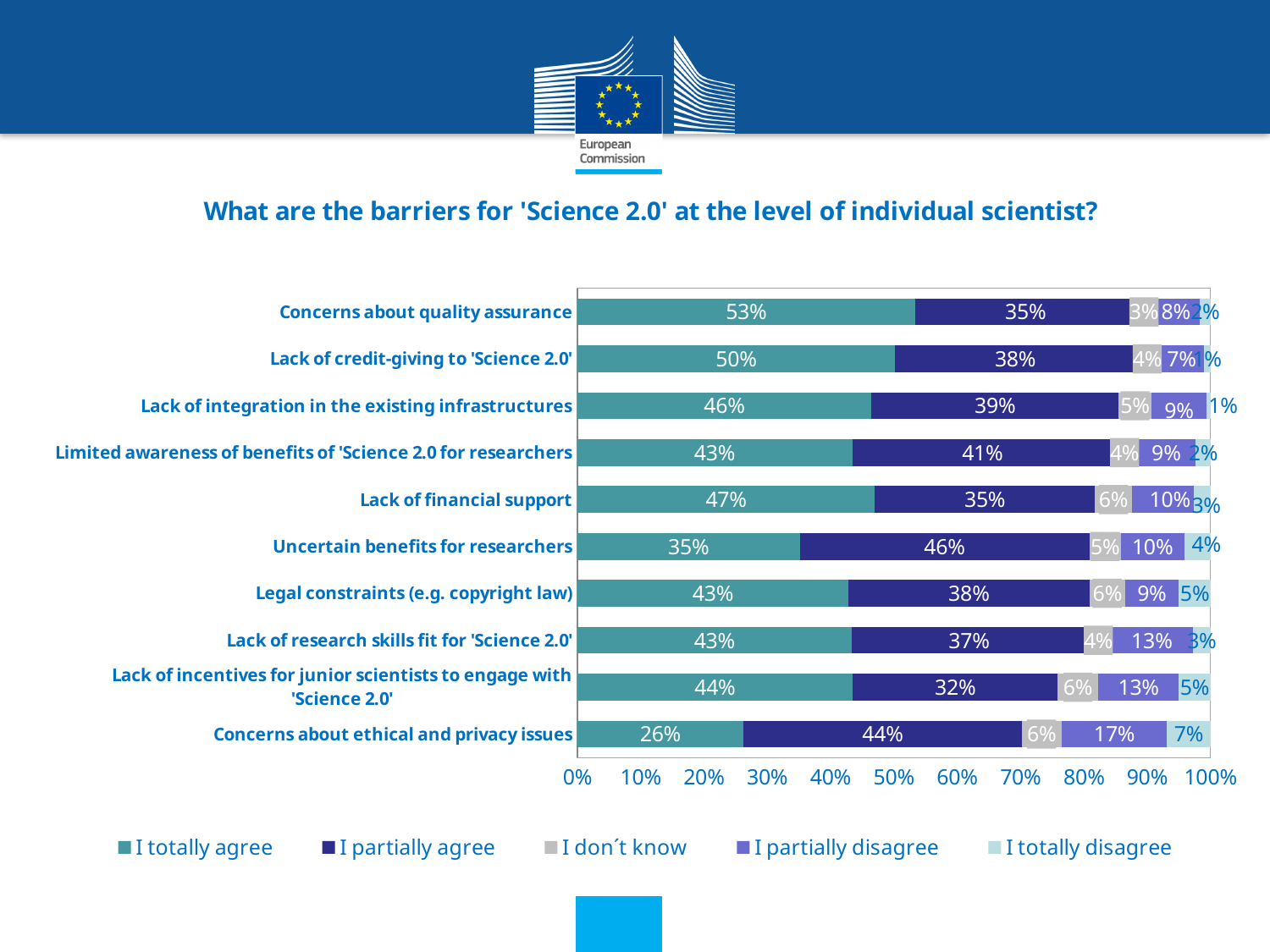
How many barriers (categories) are shown in the chart? 10 Which barrier has the highest 'I totally agree' share? Concerns about quality assurance What is the 'I partially disagree' value for 'Concerns about ethical and privacy issues'? 17% What is the 'I totally agree' value for 'Lack of incentives for junior scientists to engage with 'Science 2.0''? 44% Which barrier has the highest 'I partially disagree' share? Concerns about ethical and privacy issues Which barrier has the lowest 'I totally agree' share? Concerns about ethical and privacy issues Which has a larger 'I totally agree' share: 'Lack of credit-giving to 'Science 2.0'' or 'Lack of financial support'? Lack of credit-giving to 'Science 2.0' What is the difference in 'I totally agree' between 'Concerns about quality assurance' and 'Concerns about ethical and privacy issues'? 27 percentage points What type of chart is shown on the slide? Stacked bar chart How many series does the legend list? 5 What is the 'I partially agree' value for 'Uncertain benefits for researchers'? 46% What percentage of respondents said 'I totally agree' for 'Concerns about quality assurance'? 53%